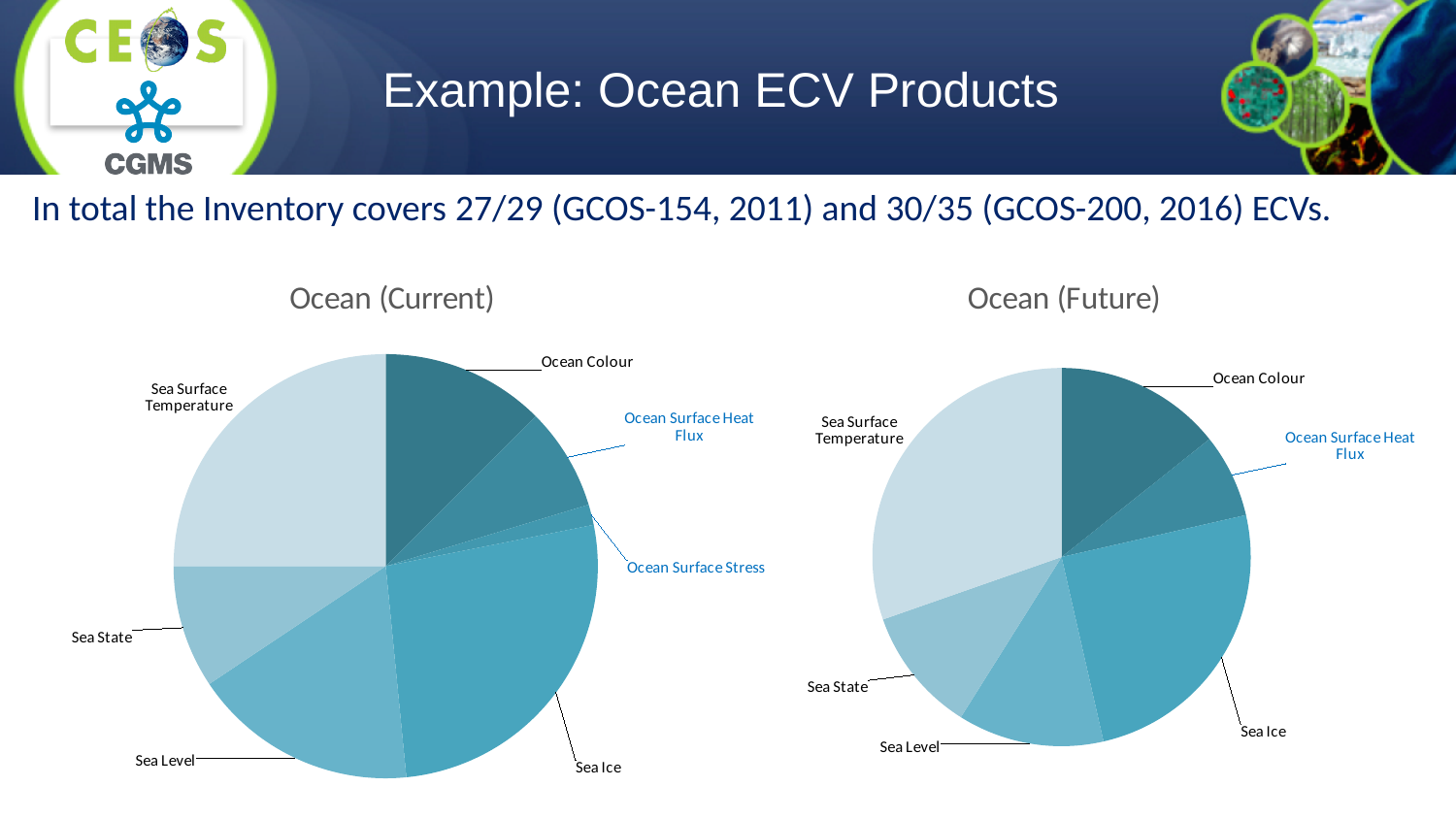
How many slices does the Ocean (Current) pie chart have? 7 In the Ocean (Future) chart, which slice is larger: Sea Ice or Ocean Surface Heat Flux? Sea Ice What kind of chart is the Ocean (Future) chart? Pie chart How many slices does the Ocean (Future) pie chart have? 6 What are the titles of the two pie charts on the slide? Ocean (Current) and Ocean (Future) Which category appears in the Ocean (Current) chart but not in the Ocean (Future) chart? Ocean Surface Stress What kind of chart is the Ocean (Current) chart? Pie chart In the Ocean (Current) chart, which slice is larger: Sea Ice or Ocean Colour? Sea Ice In the Ocean (Future) chart, which slice is larger: Sea Surface Temperature or Sea State? Sea Surface Temperature In the Ocean (Current) chart, which category has the smallest slice? Ocean Surface Stress In the Ocean (Future) chart, which category has the largest slice? Sea Surface Temperature